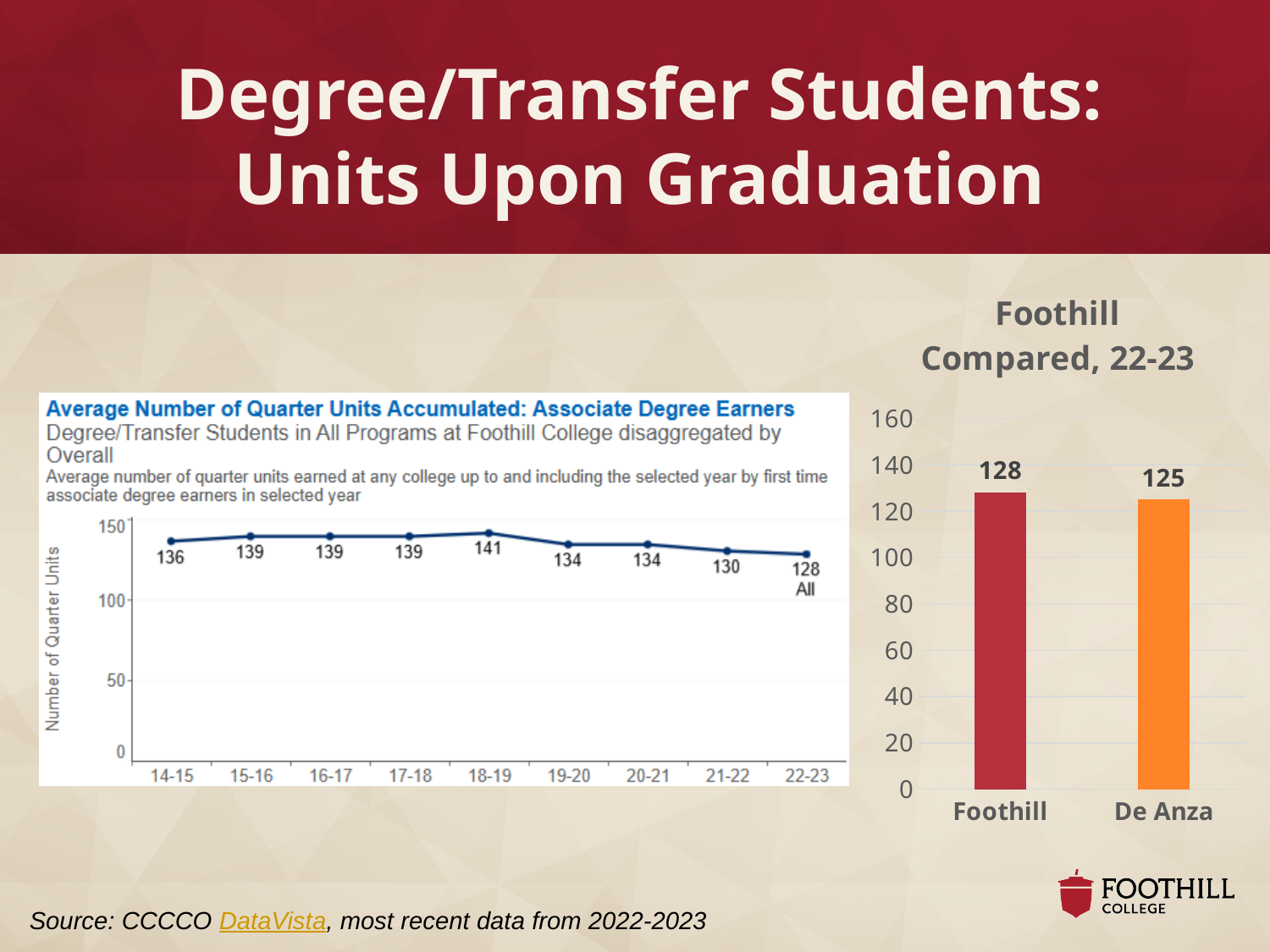
In the line chart on the left, which year has the lowest average number of quarter units? 22-23 In the line chart on the left, what is the difference between the values for 18-19 and 22-23? 13 In the bar chart titled 'Foothill Compared, 22-23', which college has the higher value, Foothill or De Anza? Foothill In the line chart on the left, what is the value for 18-19? 141 In the bar chart titled 'Foothill Compared, 22-23', what is the value for De Anza? 125 What kind of chart is the 'Foothill Compared, 22-23' chart on the right? bar chart In the line chart on the left, do the values generally rise or fall from 18-19 to 22-23? fall In the bar chart titled 'Foothill Compared, 22-23', what is the difference between Foothill and De Anza? 3 In the line chart on the left, which year has the highest average number of quarter units? 18-19 In the line chart on the left, how many years are plotted along the x axis? 9 In the line chart on the left, what is the average number of quarter units for 14-15? 136 In the bar chart titled 'Foothill Compared, 22-23', what colour is the De Anza bar? orange